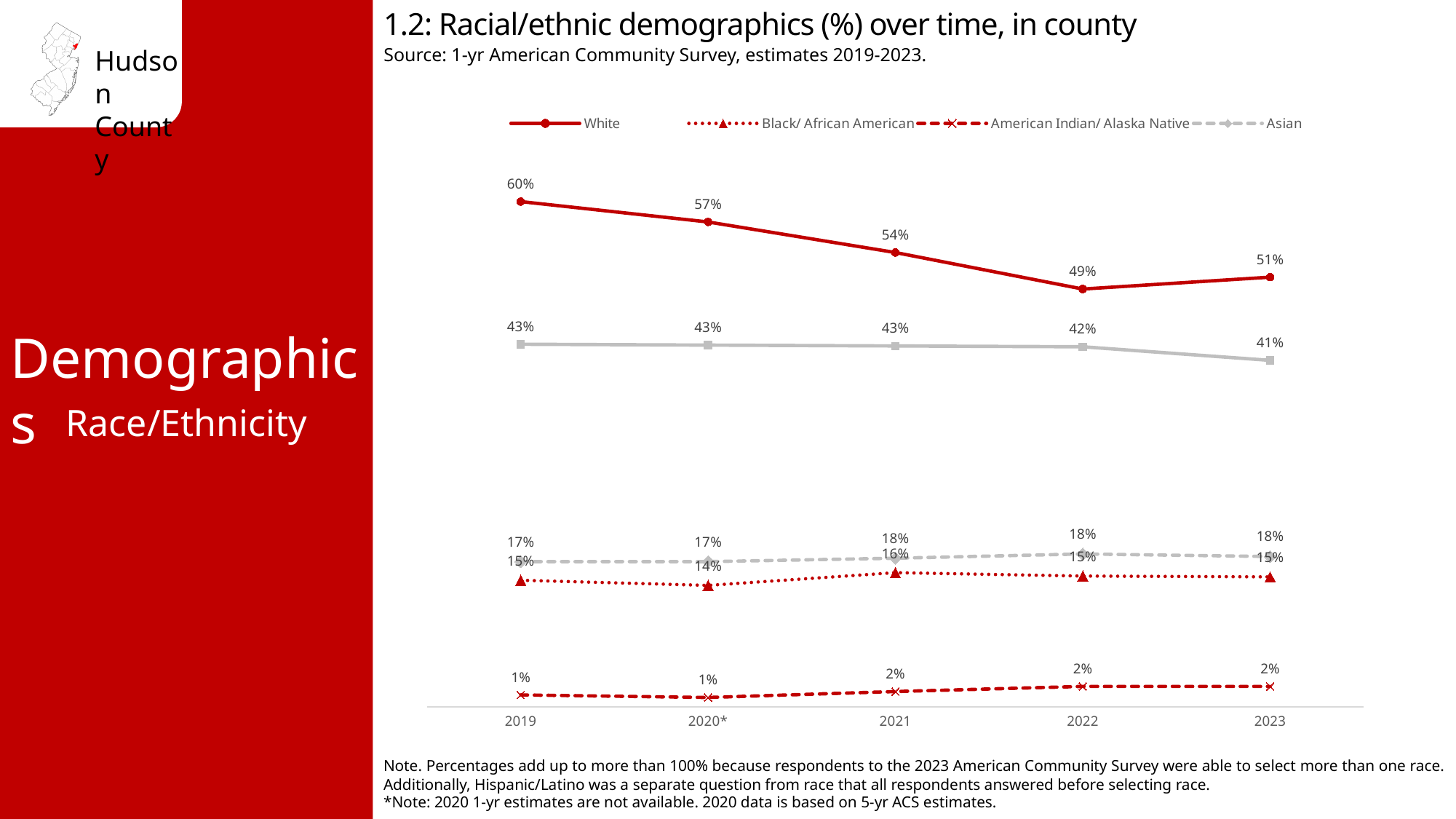
What was the White percentage in 2019? 60% Does the White series generally rise or fall from 2019 to 2022? fall What type of chart is shown on the slide? line chart What was the American Indian/ Alaska Native percentage in 2021? 2% Which was larger in 2021, the Asian percentage or the Black/ African American percentage? Asian By how many percentage points did the White percentage fall from 2019 to 2023? 9 What is the title of the chart? 1.2: Racial/ethnic demographics (%) over time, in county What was the White percentage in 2022? 49% What was the Black/ African American percentage in 2020*? 14% What was the Asian percentage in 2023? 18% In which year was the White percentage lowest? 2022 How many years are shown on the x axis? 5